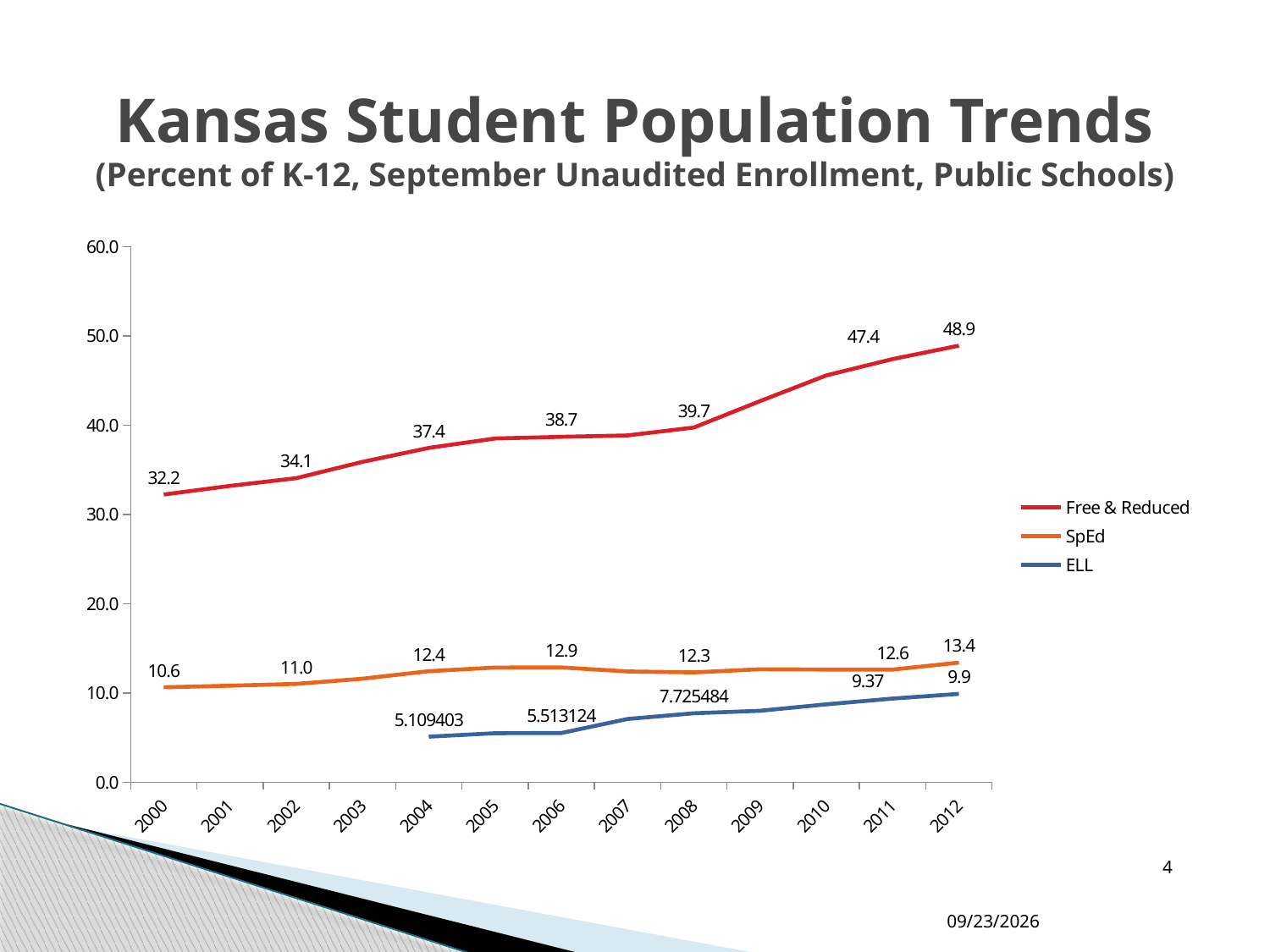
What is the Free & Reduced value for 2012? 48.9 What is the difference between the Free & Reduced values for 2012 and 2000? 16.7 Is the Free & Reduced value for 2010 greater or less than 40.0? greater What is the SpEd value for 2000? 10.6 In which year does the Free & Reduced series reach its highest value? 2012 Does the Free & Reduced series rise or fall from 2000 to 2012? rise What is the Free & Reduced value for 2006? 38.7 Which is larger in 2012, the SpEd value or the ELL value? SpEd What is the ELL value for 2008? 7.725484 What type of chart is shown on the slide? line chart How many years are shown on the x axis? 13 How many series does the legend list? 3